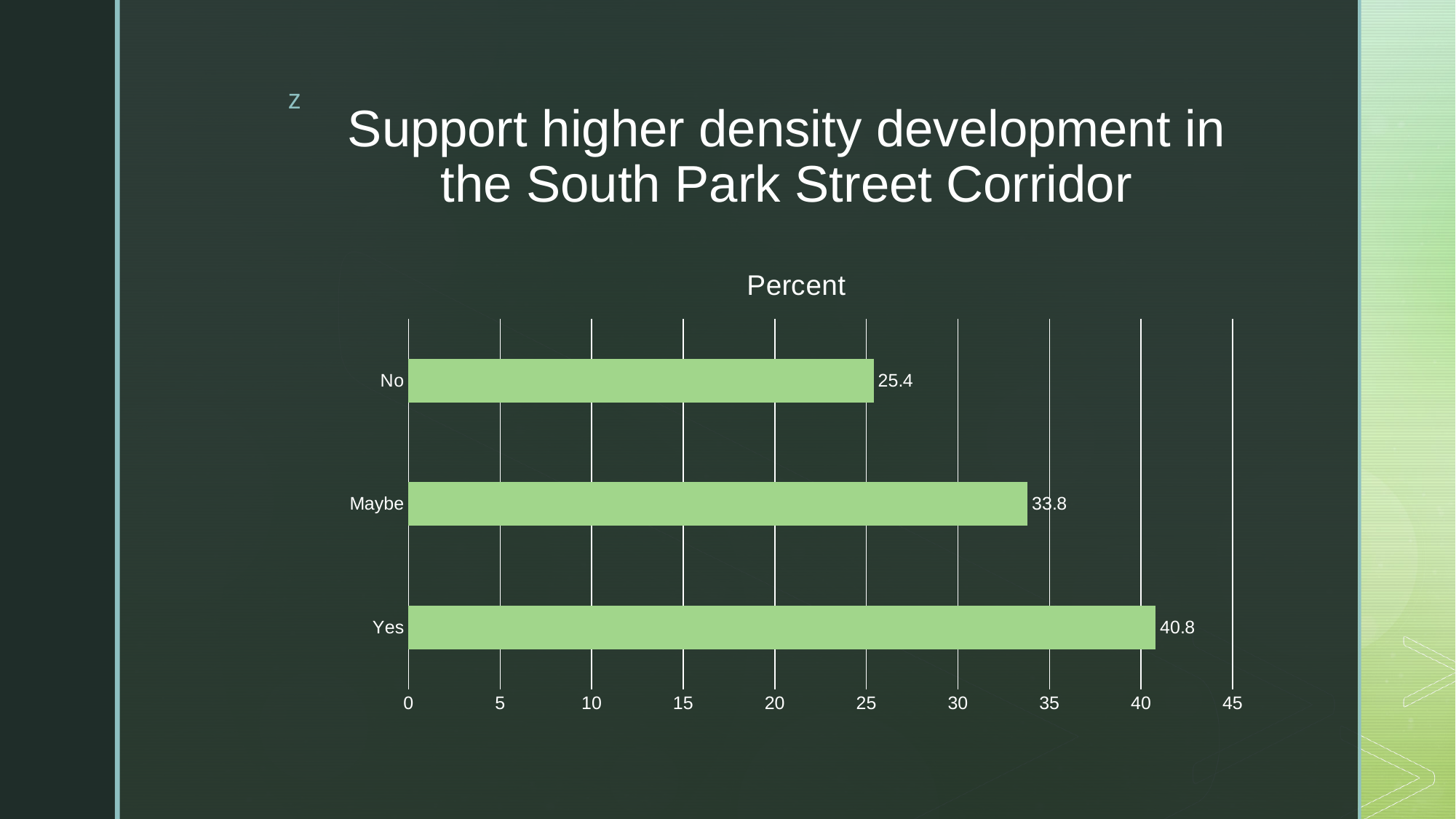
Is the value for Maybe greater or less than 30? greater What is the value for Yes? 40.8 What is the value for Maybe? 33.8 Which is larger, the value for Maybe or the value for No? Maybe Which category has the lowest value? No What is the title of the chart? Percent What kind of chart is shown on the slide? bar chart What is the difference between the values for Yes and No? 15.4 What is the value for No? 25.4 What is the difference between the values for Maybe and No? 8.4 Which category has the highest value? Yes How many categories are shown in the chart? 3